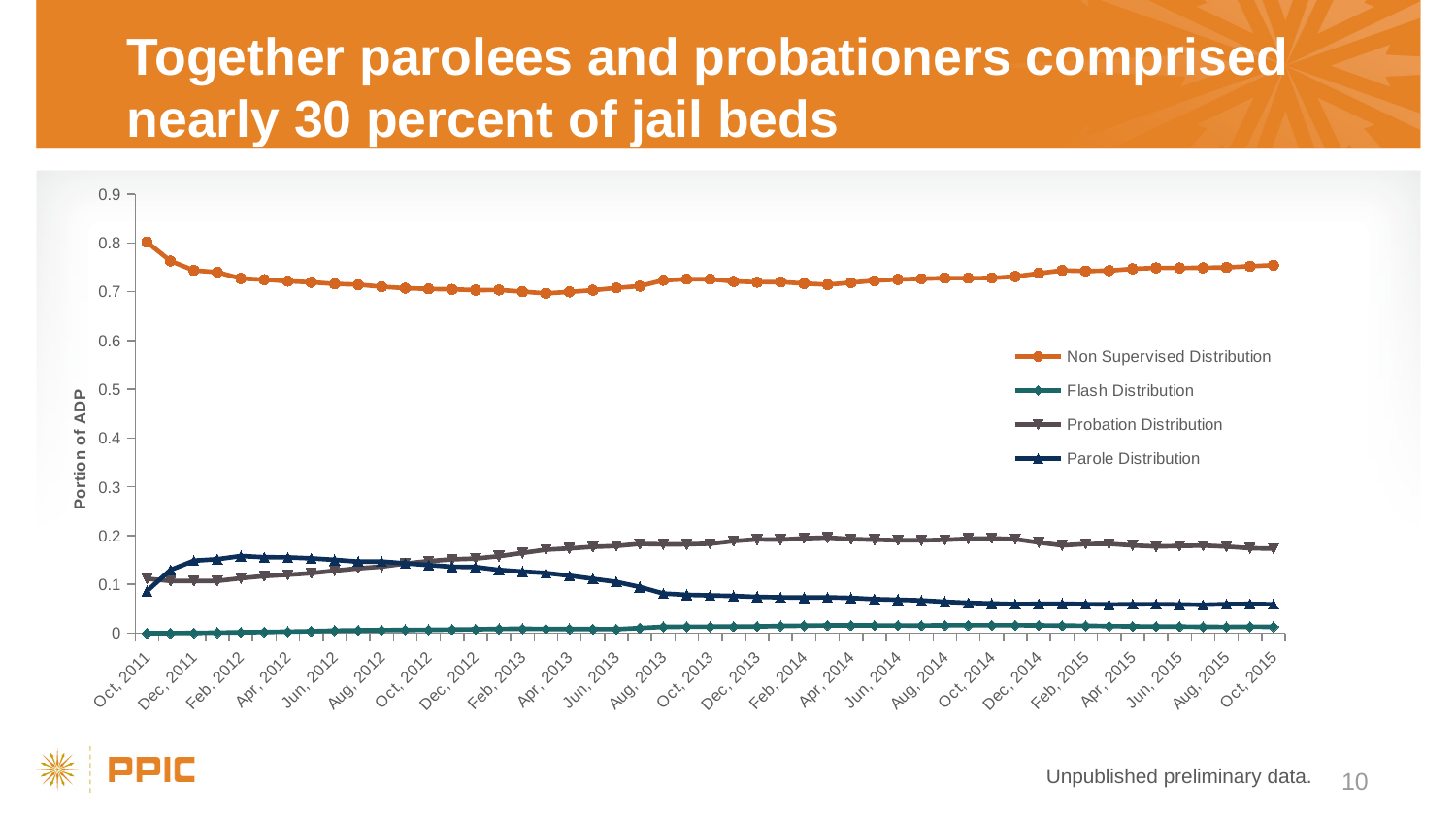
Which series has the highest values throughout the chart? Non Supervised Distribution How many series does the legend list? 4 In Oct 2015, which is larger: Probation Distribution or Parole Distribution? Probation Distribution Does the Parole Distribution line rise or fall between Feb 2012 and Oct 2015? fall Does the Probation Distribution line rise or fall between Oct 2011 and Feb 2014? rise Which series has the lowest values throughout the chart? Flash Distribution Is the value for Non Supervised Distribution in Oct 2011 greater or less than 0.7? greater What kind of chart is shown on the slide? line chart Is the value for Probation Distribution in Feb 2014 greater or less than 0.3? less Is the value for Parole Distribution in Oct 2015 greater or less than 0.1? less What is the label on the vertical axis of the chart? Portion of ADP In Feb 2012, which is larger: Parole Distribution or Probation Distribution? Parole Distribution